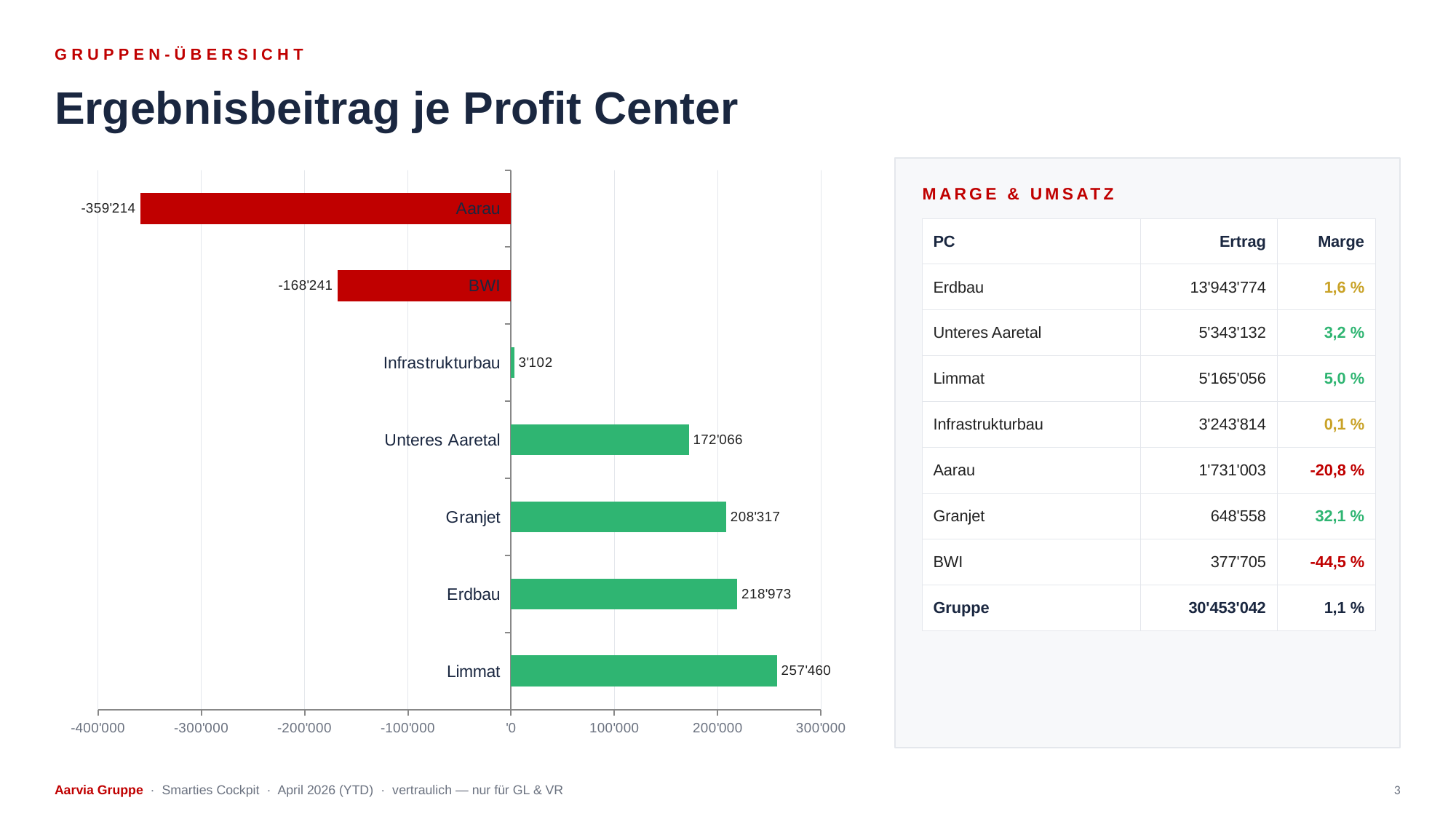
Which has the larger value, Erdbau or Granjet? Erdbau Is the value for Unteres Aaretal greater or less than 200'000? less What is the value shown for Aarau in the chart? -359'214 Which profit center has the lowest value in the chart? Aarau What is the Ergebnisbeitrag value for Limmat? 257'460 What colour are the bars with negative values in the chart? red Which profit center has the highest value in the chart? Limmat What is the difference between the values for Limmat and Erdbau? 38'487 How many profit centers are shown in the chart? 7 What is the difference between the values for Granjet and Unteres Aaretal? 36'251 What is the value shown for Infrastrukturbau in the chart? 3'102 What type of chart is shown on the slide? bar chart